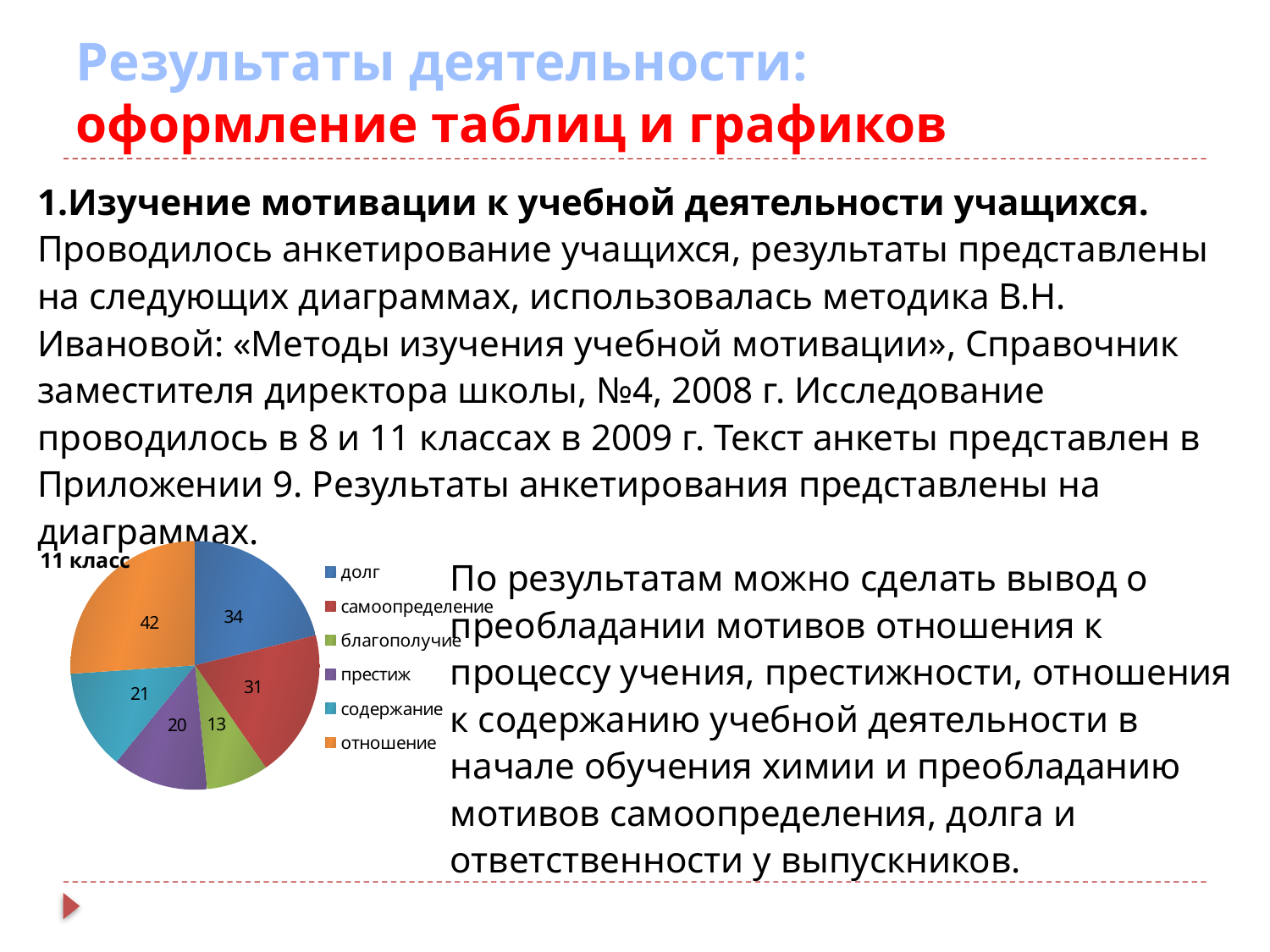
Which category has the largest slice in the pie chart? отношение What is the value for отношение in the pie chart? 42 Which category has the smallest slice in the pie chart? благополучие What is the value for самоопределение in the pie chart? 31 Which is larger, the value for престиж or the value for содержание? содержание What is the value for долг in the pie chart? 34 How many slices does the pie chart have? 6 What is the value for благополучие in the pie chart? 13 What is the difference between the values for отношение and долг? 8 What kind of chart is shown on the slide? pie chart What colour is the slice for самоопределение? red What is the title of the pie chart? 11 класс